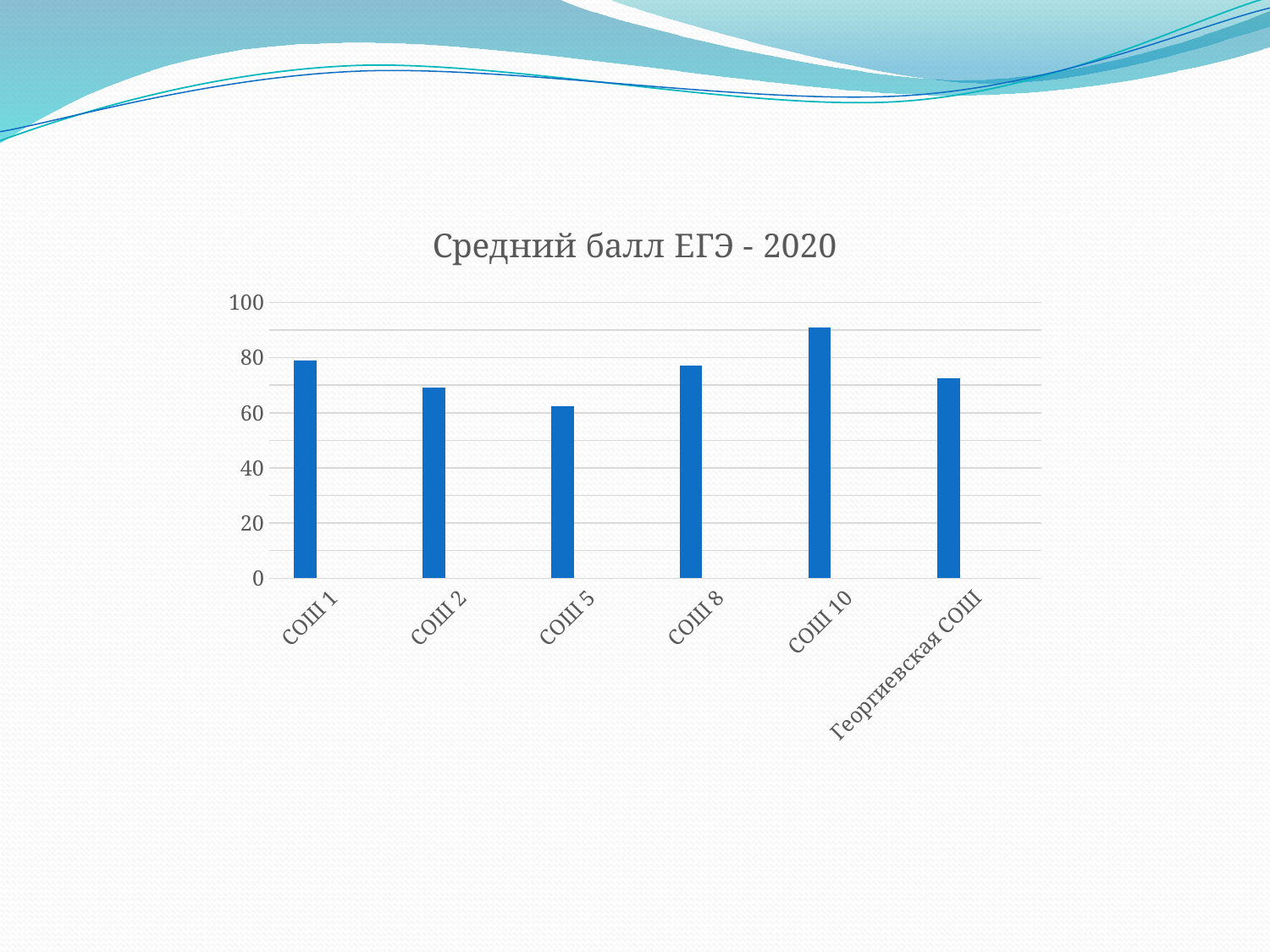
Which school has the lowest average score on the chart? СОШ 5 Which is larger, the value for СОШ 2 or the value for СОШ 5? СОШ 2 How many schools (categories) are shown on the chart? 6 Is the value for СОШ 2 greater or less than 80? less Which is larger, the value for СОШ 10 or the value for СОШ 1? СОШ 10 Is the value for СОШ 1 greater or less than 60? greater What kind of chart is shown on the slide? bar chart Which school has the highest average score on the chart? СОШ 10 What is the title of the chart? Средний балл ЕГЭ - 2020 Is the value for СОШ 5 greater or less than 80? less